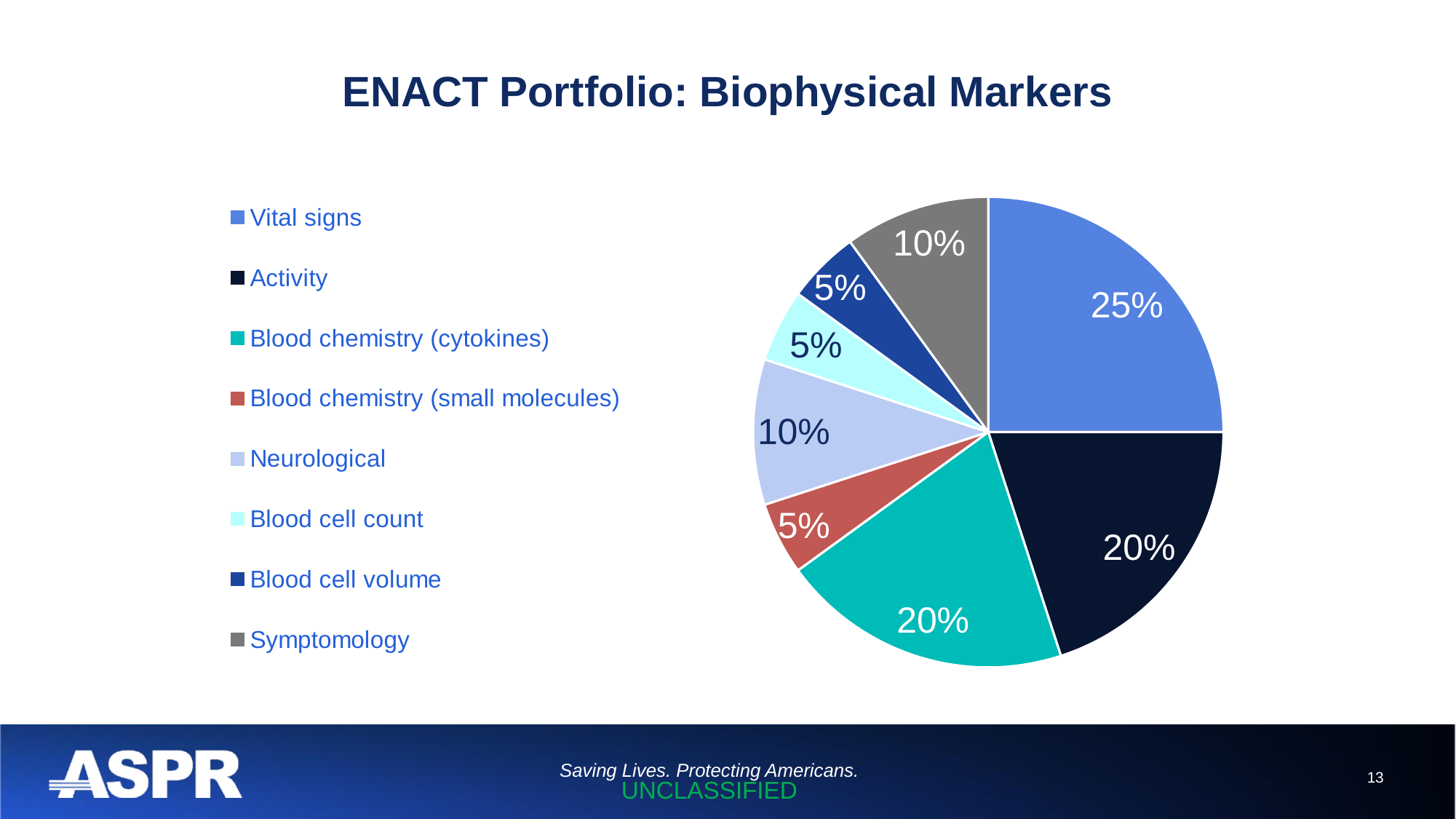
What percentage is shown for Activity? 20% What share of the pie does Vital signs represent? 25% What kind of chart is shown on the slide? Pie chart Which is larger, the share for Activity or the share for Blood chemistry (small molecules)? Activity What percentage is shown for Neurological? 10% How many categories are shown in the pie chart? 8 What is the value for Blood chemistry (cytokines)? 20% What share does Symptomology have? 10% What is the value for Blood cell volume? 5% What is the title of the slide containing the chart? ENACT Portfolio: Biophysical Markers Which category has the largest slice of the pie? Vital signs What is the difference between the Vital signs share and the Neurological share? 15%